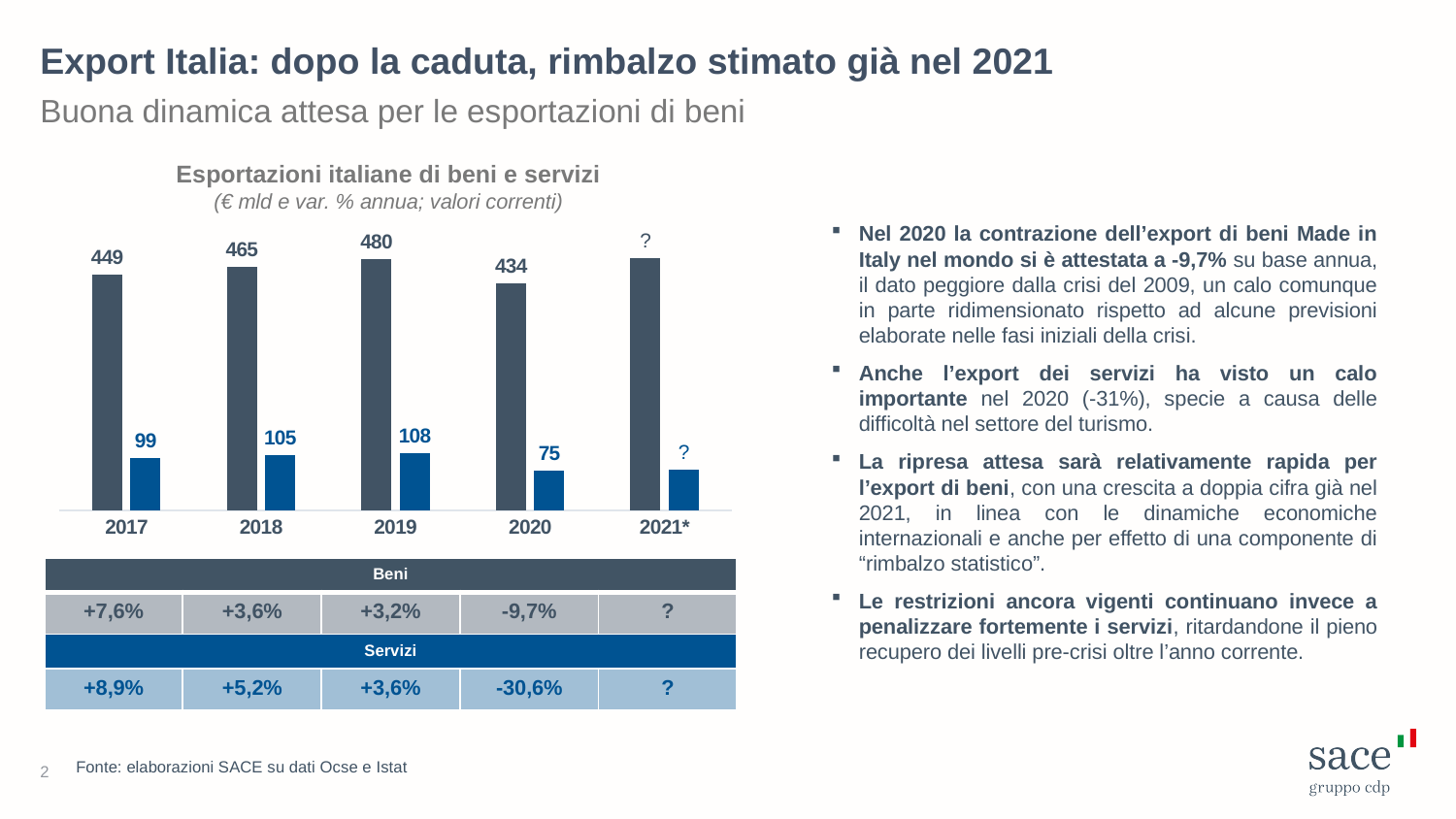
By how much did Beni exports fall from 2019 to 2020? 46 What kind of chart is used to show Italian exports of goods and services? Bar chart Which year has the larger Beni export value, 2017 or 2018? 2018 What is the difference between Servizi exports in 2019 and 2020? 33 What is the value of Servizi (services) exports in 2020? 75 According to the table below the chart, what is the annual % change for Beni in 2020? -9,7% According to the table below the chart, what is the annual % change for Servizi in 2020? -30,6% In which year are Servizi exports lowest among the labelled values? 2020 Do Servizi exports rise or fall from 2017 to 2019? Rise What is the value of Beni (goods) exports in 2019? 480 How many years are shown on the x axis of the chart? 5 In which year are Beni exports highest among the labelled values? 2019